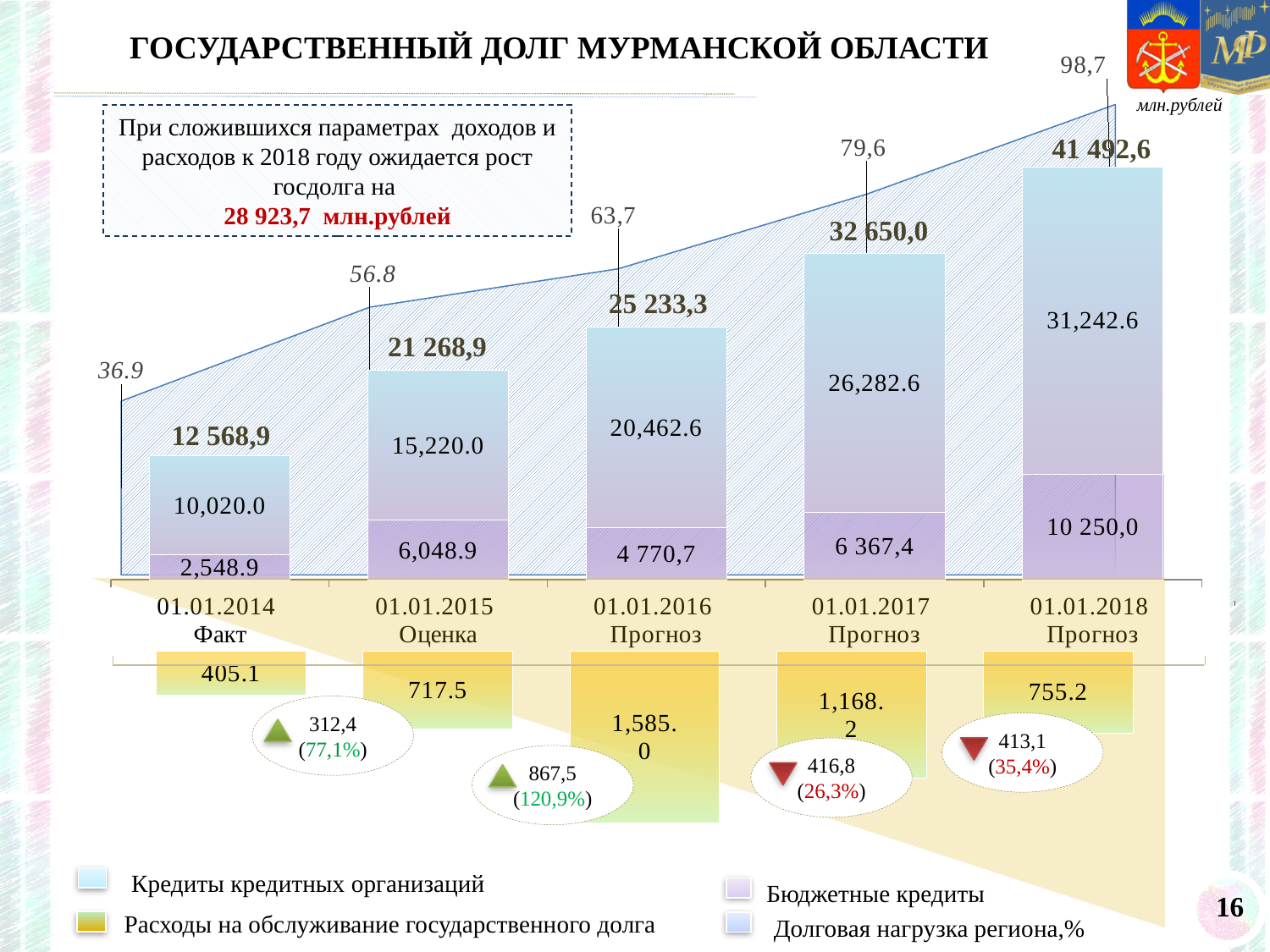
Which date has the highest total state debt? 01.01.2018 Which date has the highest expenses on servicing state debt? 01.01.2016 What is the regional debt load percentage (Долговая нагрузка региона,%) for 01.01.2017? 79,6 Does the regional debt load percentage rise or fall from 01.01.2014 to 01.01.2018? rise Is the value of budget credits larger for 01.01.2016 or for 01.01.2017? 01.01.2017 What is the value of budget credits (Бюджетные кредиты) for 01.01.2015? 6,048.9 What is the total state debt shown for 01.01.2018? 41 492,6 How many dates are shown on the x axis of the chart? 5 What kind of chart is used to show the state debt by date? stacked bar chart What is the value of credits from credit organizations (Кредиты кредитных организаций) for 01.01.2016? 20,462.6 Which date has the lowest value of budget credits (Бюджетные кредиты)? 01.01.2014 What are the expenses on servicing state debt (Расходы на обслуживание государственного долга) for 01.01.2016? 1,585.0